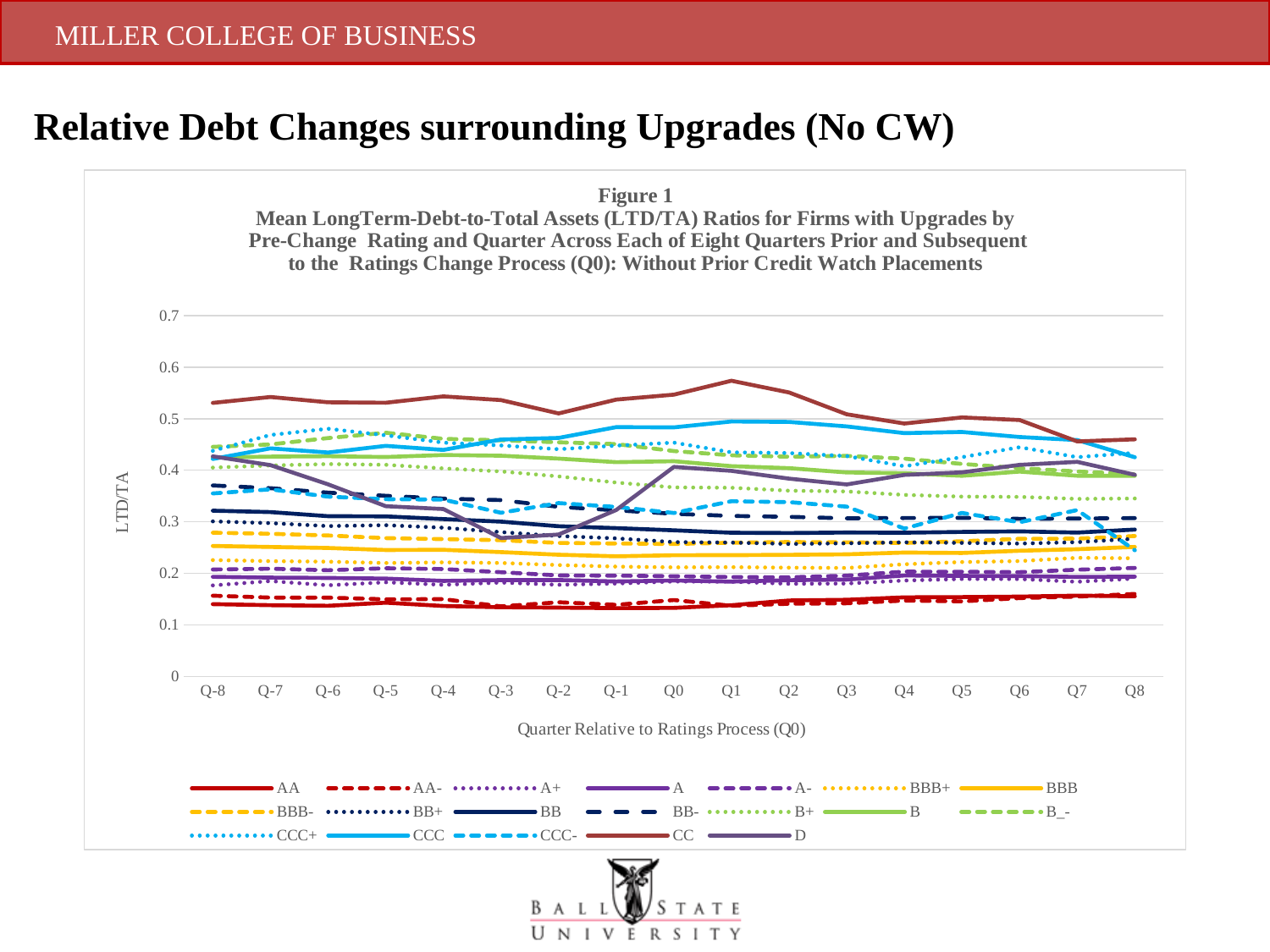
Is the value for D at Q0 greater or less than 0.3? greater How many quarters are plotted along the x axis of Figure 1? 17 Is the value for AA at Q0 greater or less than 0.2? less What is the label of the y axis in Figure 1? LTD/TA Does the CC series rise or fall from Q1 to Q4? fall At Q1, which series has the larger value, CCC or BB? CCC How many series does the legend of Figure 1 list? 19 What kind of chart is shown in Figure 1? line chart Which rating series has the highest LTD/TA values across the chart? CC Is the value for CC at Q1 greater or less than 0.5? greater What is the label of the x axis in Figure 1? Quarter Relative to Ratings Process (Q0)